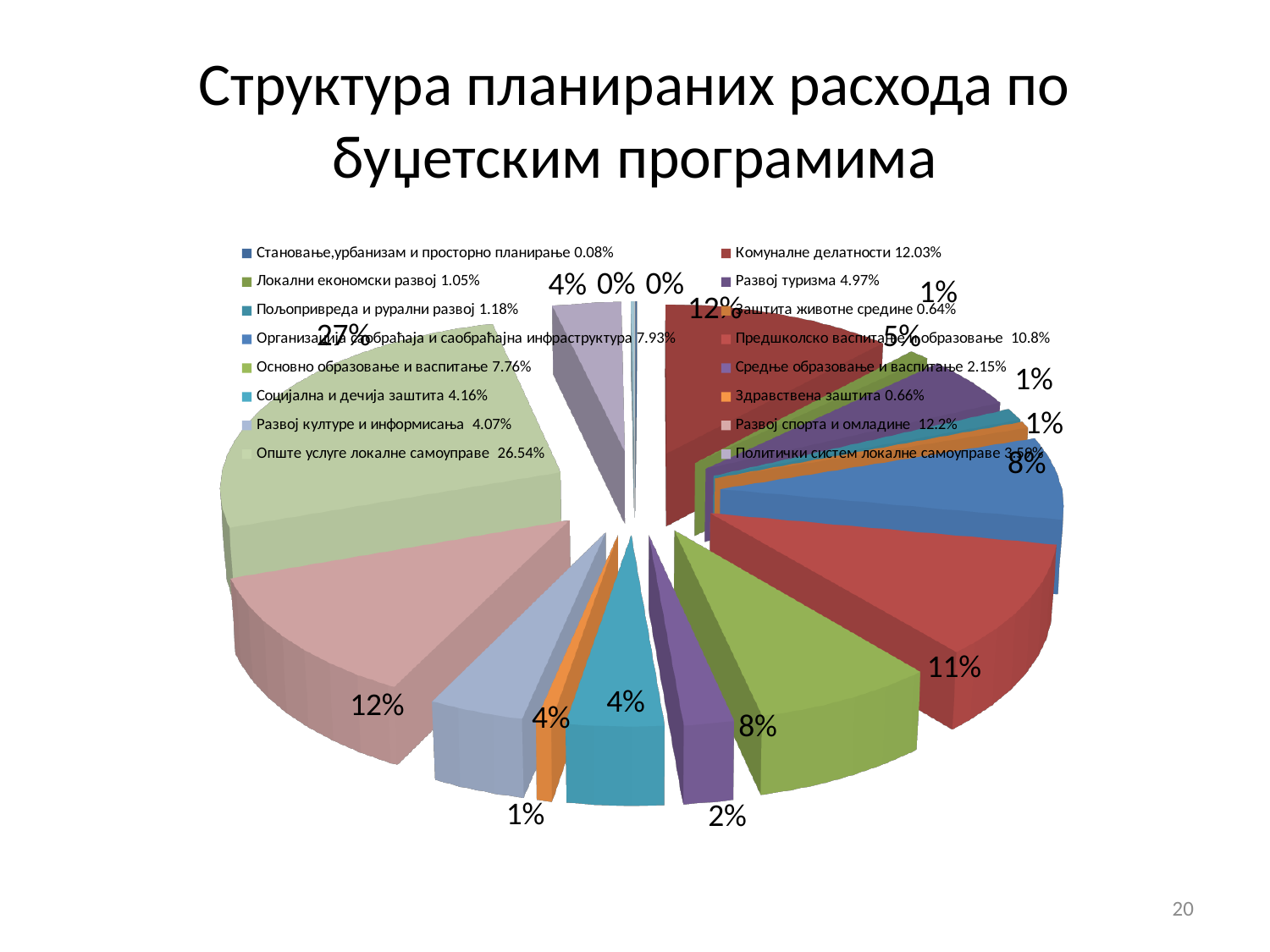
What percentage is shown for Комуналне делатности? 12.03% How many categories does the pie chart's legend list? 16 What percentage is shown for Предшколско васпитање и образовање? 10.8% What percentage is shown for Опште услуге локалне самоуправе? 26.54% Which category has the smallest share of the pie? Становање,урбанизам и просторно планирање What percentage is shown for Развој туризма? 4.97% What is the title of the chart on the slide? Структура планираних расхода по буџетским програмима What percentage is shown for Социјална и дечија заштита? 4.16% Which category has the largest share of the pie? Опште услуге локалне самоуправе What is the difference between the shares for Опште услуге локалне самоуправе and Развој спорта и омладине? 14.34% What kind of chart is shown on the slide? pie chart Which is larger: the share for Предшколско васпитање и образовање or for Организација саобраћаја и саобраћајна инфраструктура? Предшколско васпитање и образовање